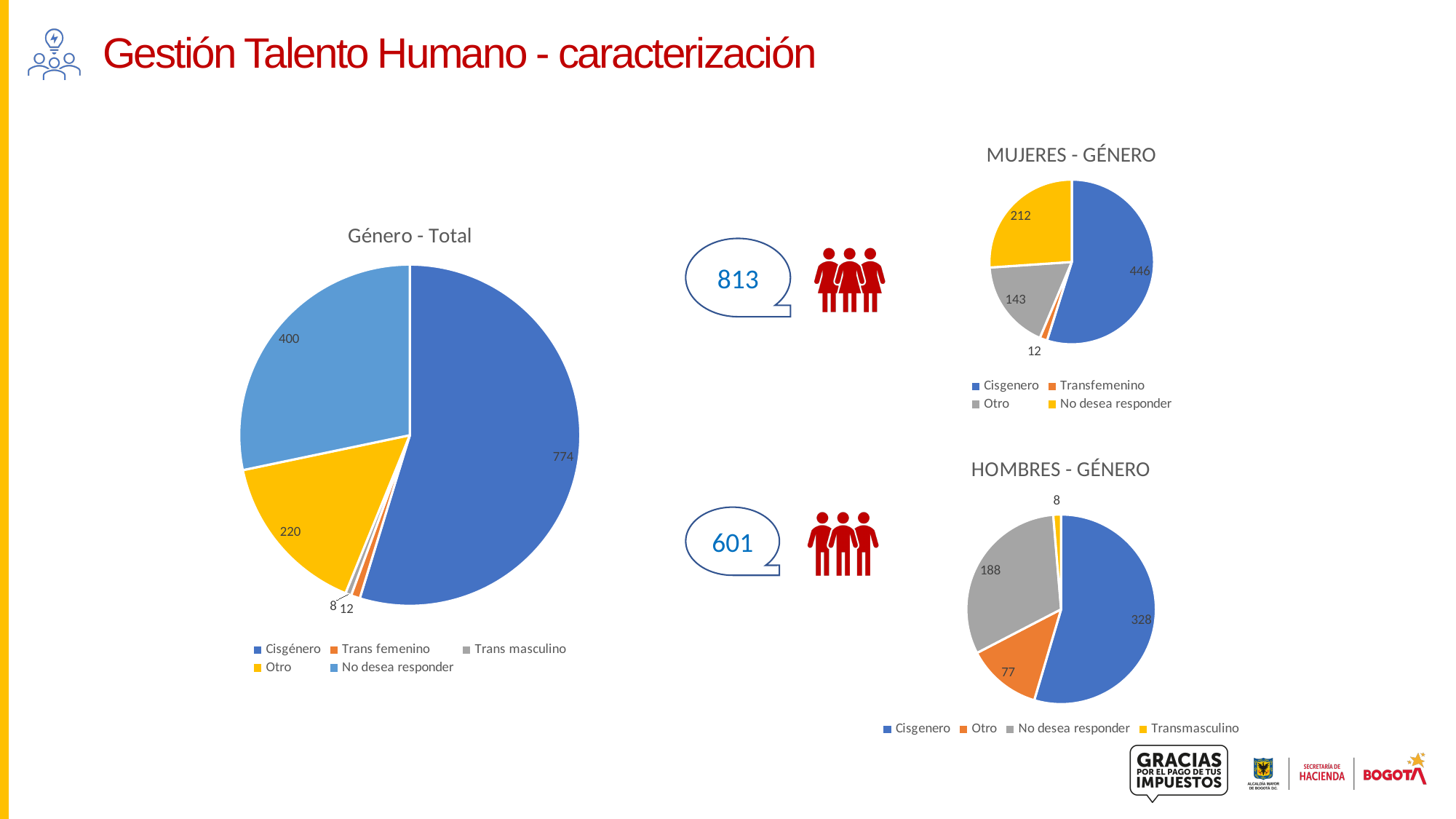
In the 'Género - Total' chart, how many categories does the legend list? 5 In the 'MUJERES - GÉNERO' chart, what is the difference between Cisgenero and No desea responder? 234 In the 'HOMBRES - GÉNERO' chart, what is the value for Transmasculino? 8 In the 'HOMBRES - GÉNERO' chart, which is larger, Otro or No desea responder? No desea responder In the 'HOMBRES - GÉNERO' chart, what is the value for No desea responder? 188 What kind of chart is 'MUJERES - GÉNERO'? Pie chart In the 'MUJERES - GÉNERO' chart, what is the value for Otro? 143 In the 'Género - Total' chart, what is the value for Cisgénero? 774 In the 'MUJERES - GÉNERO' chart, which category has the highest value? Cisgenero In the 'Género - Total' chart, what is the value for No desea responder? 400 In the 'Género - Total' chart, what is the difference between Otro and No desea responder? 180 In the 'Género - Total' chart, which category has the lowest value? Trans masculino